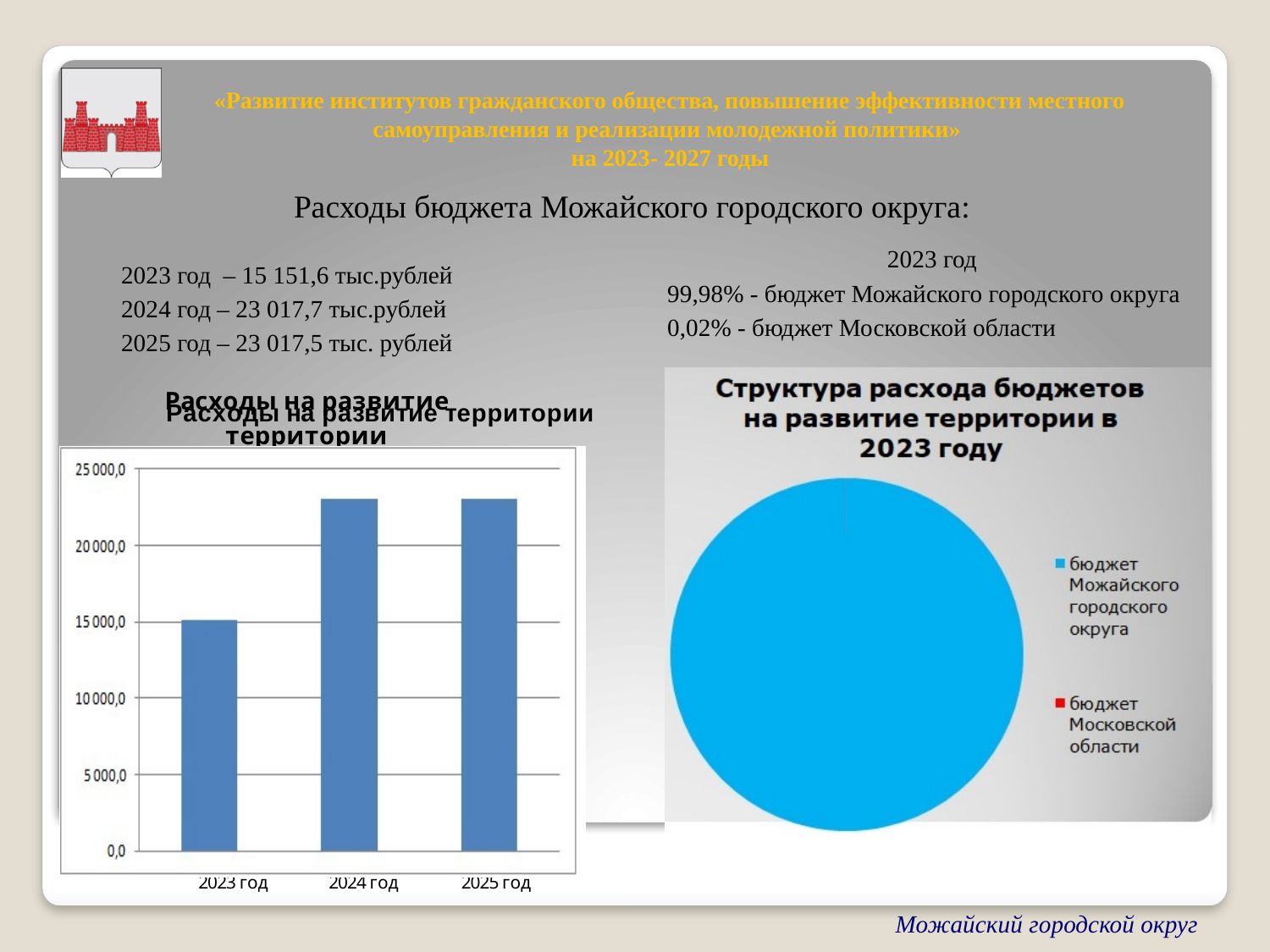
In the bar chart «Расходы на развитие территории», is the value for 2024 год greater or less than 20 000,0? greater In the bar chart «Расходы на развитие территории», which year has the lowest value? 2023 год In the pie chart «Структура расхода бюджетов на развитие территории в 2023 году», what share does «бюджет Можайского городского округа» have according to the slide? 99,98% How many entries does the legend of the pie chart «Структура расхода бюджетов на развитие территории в 2023 году» list? 2 What kind of chart is the chart titled «Структура расхода бюджетов на развитие территории в 2023 году»? pie chart In the pie chart «Структура расхода бюджетов на развитие территории в 2023 году», which legend entry is shown in red? бюджет Московской области In the bar chart «Расходы на развитие территории», how many years are shown on the x axis? 3 In the bar chart «Расходы на развитие территории», is the value for 2023 год greater or less than 20 000,0? less What kind of chart is the chart titled «Расходы на развитие территории»? bar chart In the bar chart «Расходы на развитие территории», is the value for 2025 год greater or less than 25 000,0? less In the bar chart «Расходы на развитие территории», which is larger, the value for 2023 год or the value for 2024 год? 2024 год In the bar chart «Расходы на развитие территории», what is the value for 2023 год according to the figures printed on the slide? 15 151,6 тыс.рублей